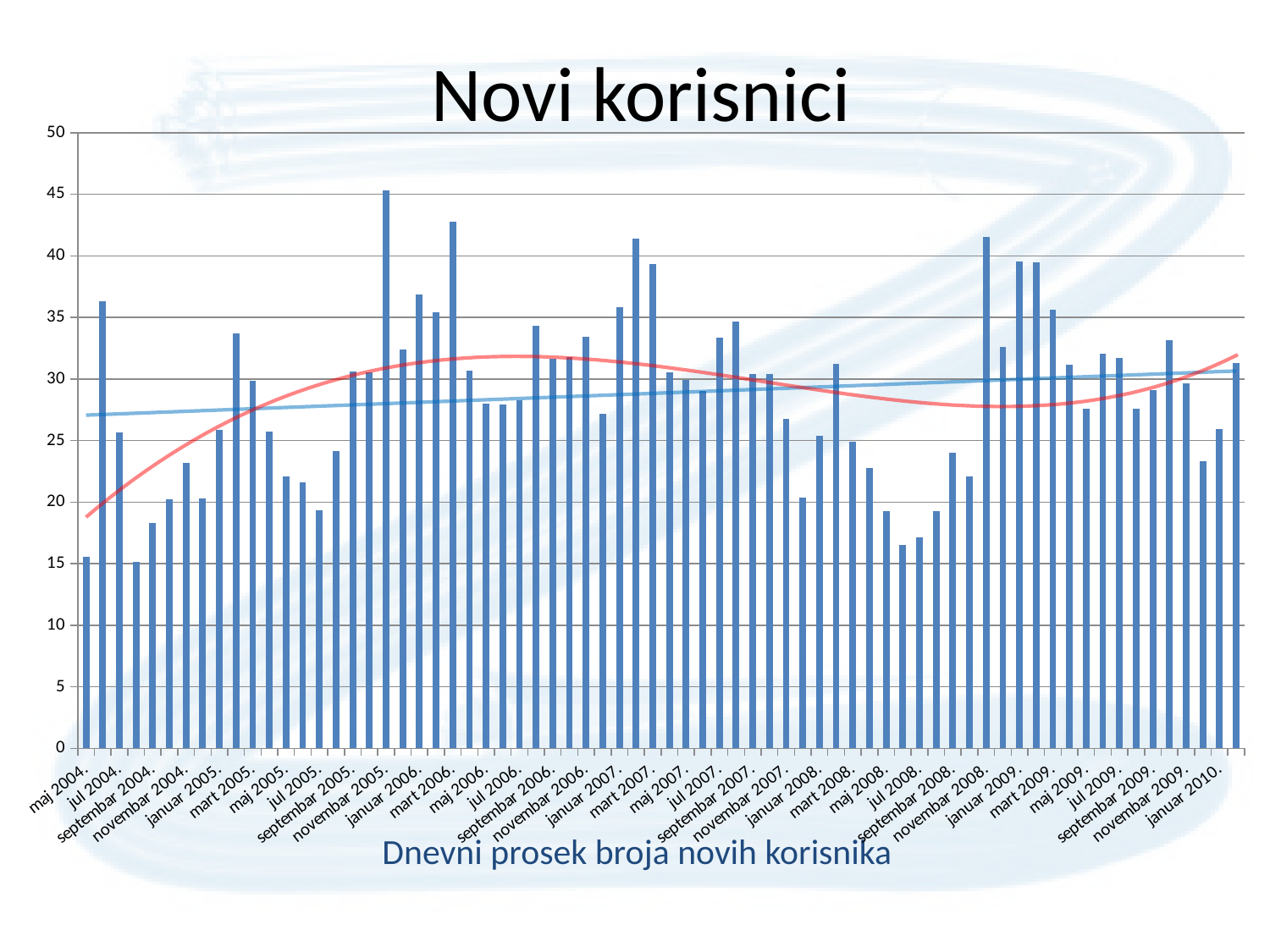
What kind of chart is shown on the slide? bar chart Is the value for novembar 2005. greater or less than 40? greater What is the title of the chart? Novi korisnici Which is larger, the value for novembar 2005. or the value for maj 2004.? novembar 2005. Is the value for maj 2004. greater or less than 20? less Does the straight blue trend line rise or fall from left to right? rise Which month has the highest bar in the chart? novembar 2005. Is the value for mart 2006. greater or less than 40? greater What is the maximum value shown on the vertical axis? 50 What caption appears below the chart's x axis? Dnevni prosek broja novih korisnika